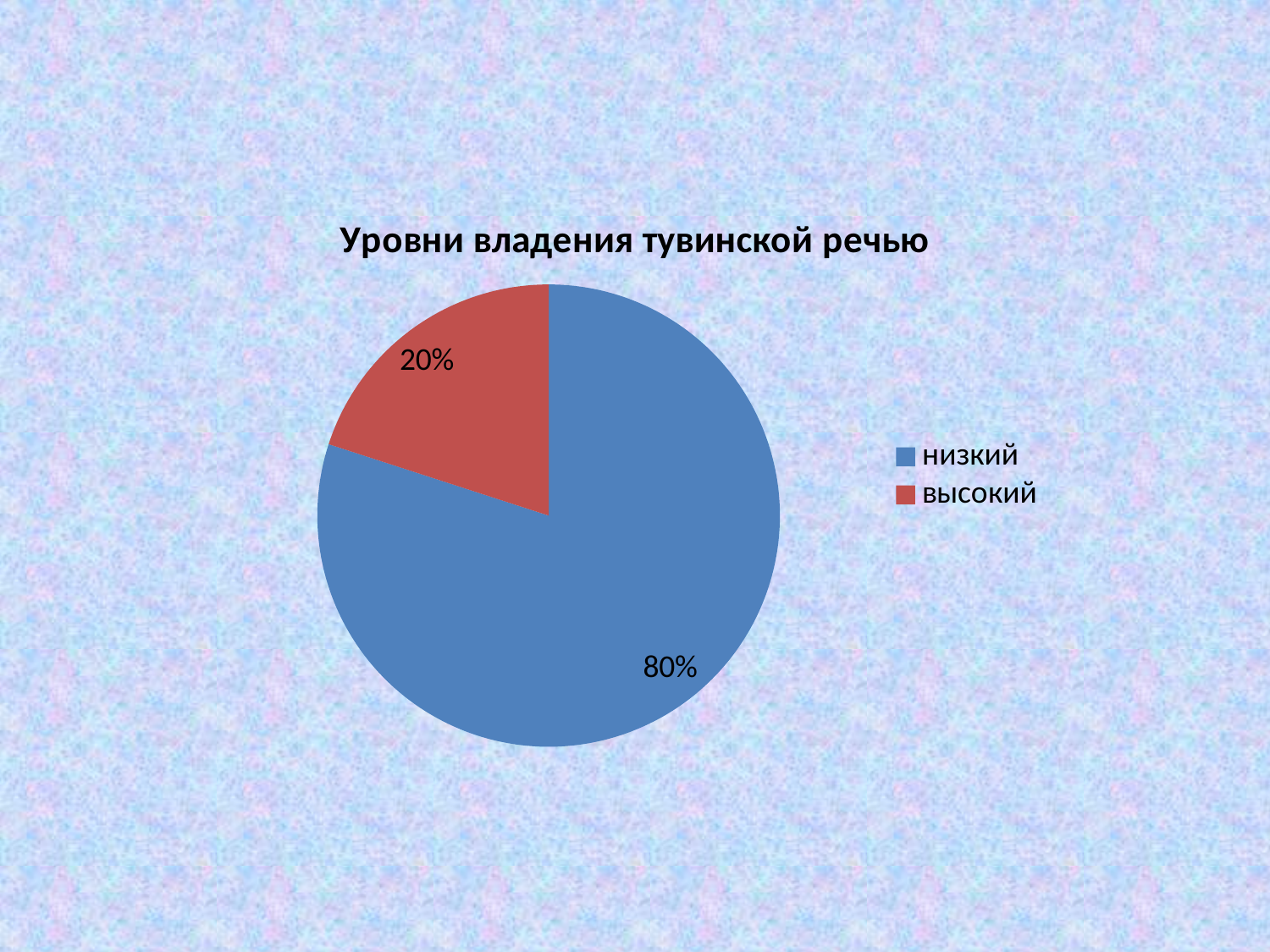
How many entries does the legend list? 2 Which is larger, the 'низкий' slice or the 'высокий' slice? низкий What is the difference in percentage points between the 'низкий' and 'высокий' slices? 60% Which category has the largest slice of the pie? низкий What colour is the 'высокий' slice? red Which category has the smallest slice of the pie? высокий What share of the pie does the 'низкий' slice represent? 80% What kind of chart is shown on the slide? pie chart What share of the pie does the 'высокий' slice represent? 20% What is the title of the chart? Уровни владения тувинской речью How many slices does the pie chart have? 2